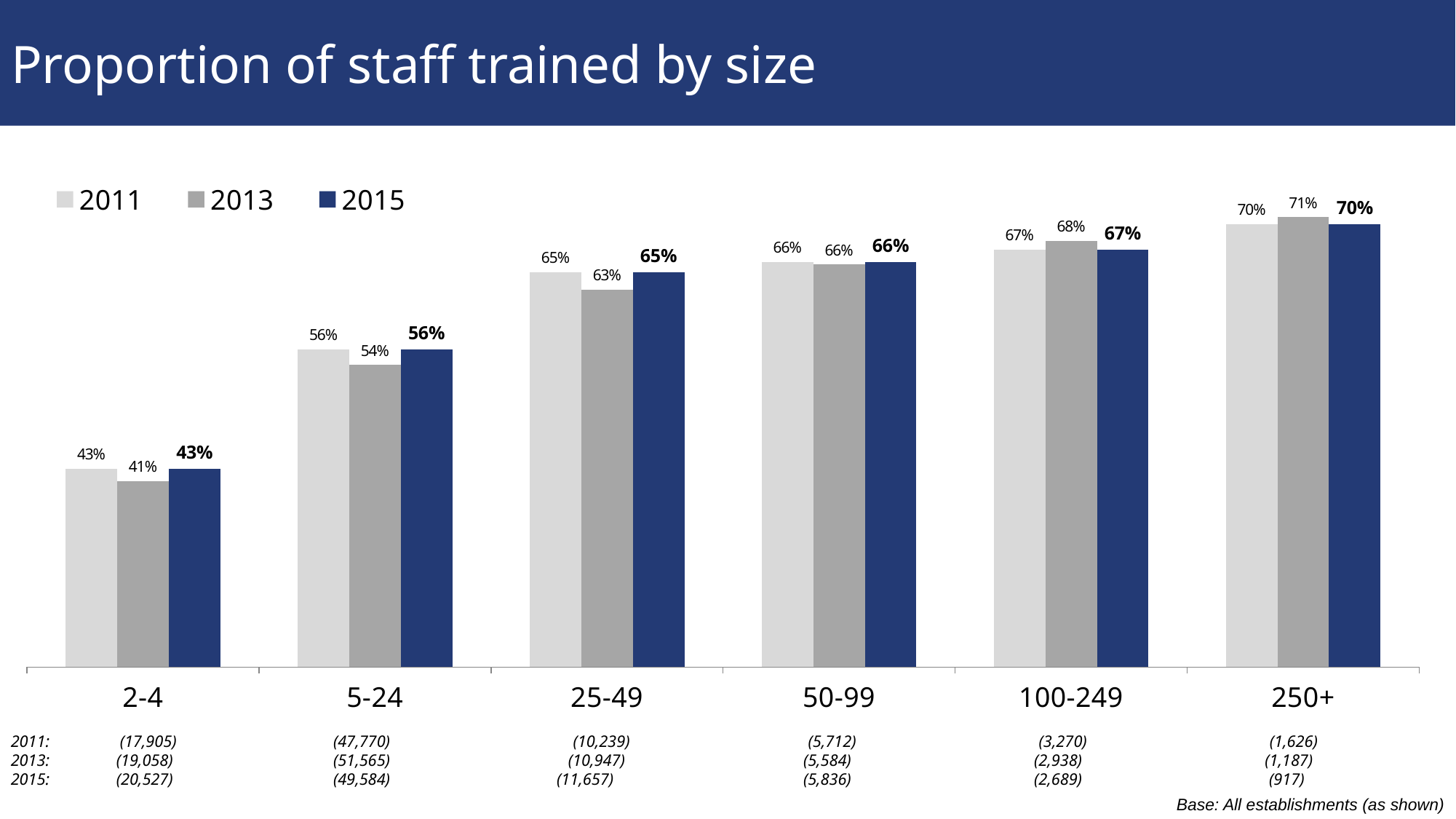
Do the 2015 values rise or fall as establishment size increases from 2-4 to 250+? Rise What is the title of the chart? Proportion of staff trained by size What is the proportion of staff trained in 2013 for establishments with 25-49 staff? 63% What kind of chart is shown on the slide? Bar chart What is the proportion of staff trained in 2015 for establishments with 2-4 staff? 43% What is the difference between the 2015 and 2013 values for the 5-24 size band? 2 percentage points Which size band has the highest proportion of staff trained in 2013? 250+ How many size bands are shown on the x axis? 6 Which size band has the lowest proportion of staff trained in 2015? 2-4 Which is larger for the 250+ size band: the 2013 value or the 2015 value? 2013 How many series does the legend list? 3 What is the proportion of staff trained in 2011 for establishments with 100-249 staff? 67%